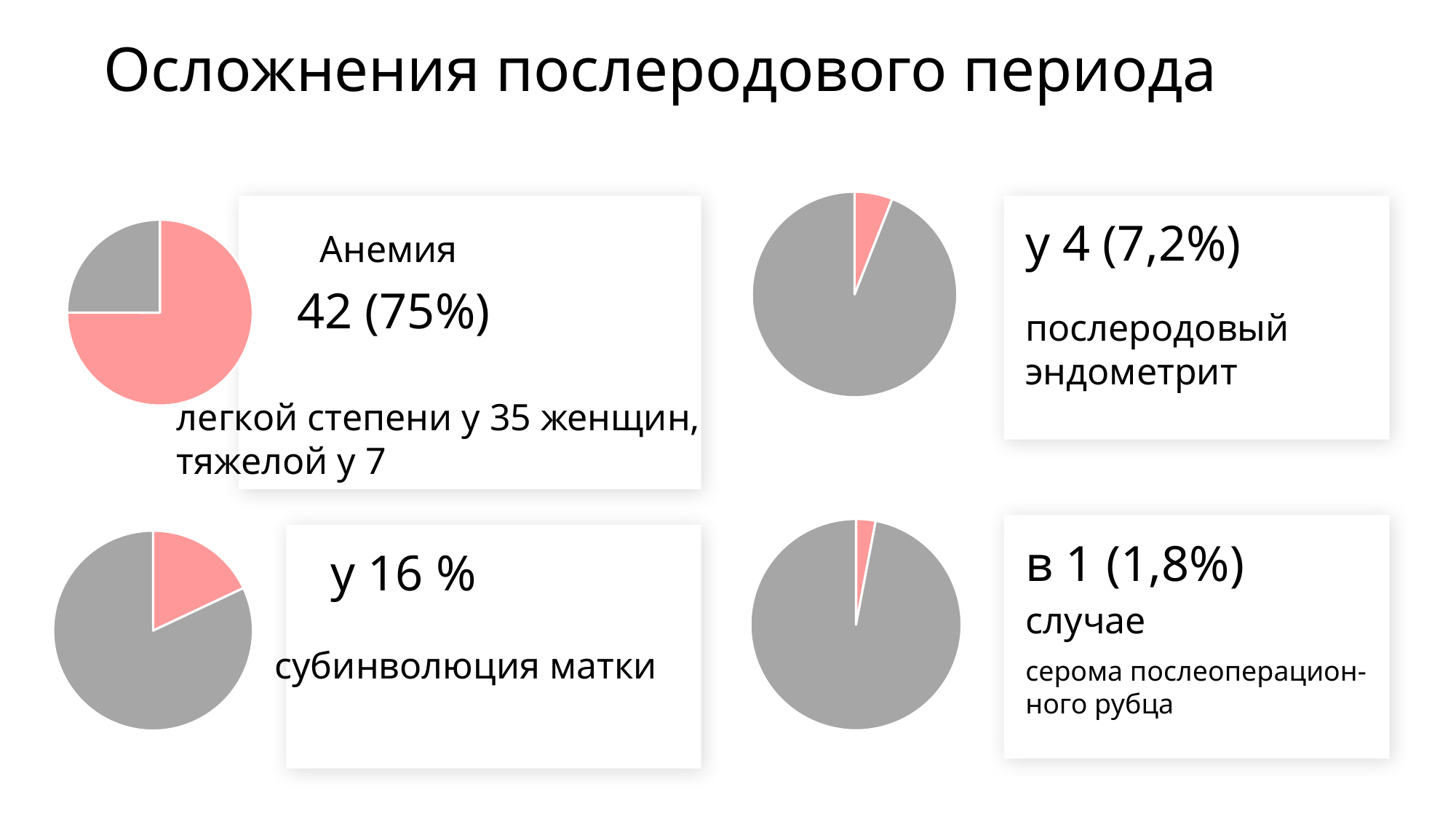
In the bottom-left pie chart (субинволюция матки), what share does the pink slice represent? 16 % How many pie charts are on the slide? 4 In the top-right pie chart (послеродовый эндометрит), how many cases does the pink slice correspond to? 4 What colour is used for the highlighted slice in each pie chart? Pink In the top-left pie chart (Анемия), what share does the pink slice represent? 75% What kind of charts are shown on the slide? Pie charts Which complication has the smallest pink slice among the four pie charts? серома послеоперационного рубца In the top-right pie chart (послеродовый эндометрит), what share does the pink slice represent? 7,2% In the top-left pie chart (Анемия), how many women does the pink slice correspond to? 42 Which pie chart has the largest pink slice: the top-left (Анемия) or the bottom-left (субинволюция матки)? Top-left (Анемия) In the bottom-right pie chart (серома послеоперационного рубца), how many cases does the pink slice correspond to? 1